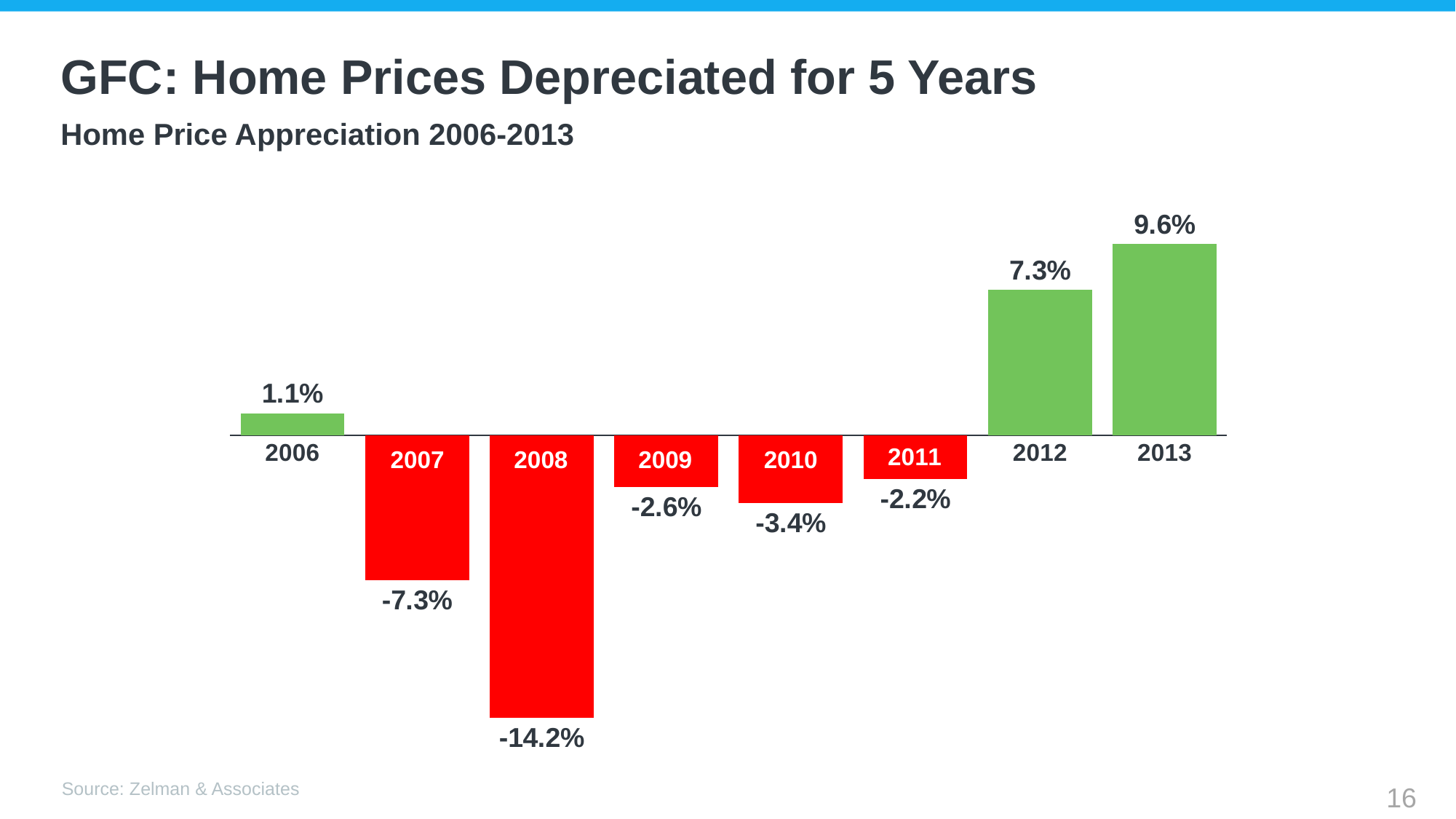
Which year has the highest home price appreciation? 2013 Which year has the larger value, 2009 or 2011? 2011 What kind of chart is shown on the slide? Bar chart How many years show a negative home price appreciation? 5 What is the home price appreciation value for 2013? 9.6% Which year has the lowest home price appreciation? 2008 What is the difference between the values for 2013 and 2012? 2.3% What is the home price appreciation value for 2008? -14.2% What is the title of the chart? Home Price Appreciation 2006-2013 What colour are the bars for years with negative values? Red How many years are shown in the chart? 8 What is the home price appreciation value for 2010? -3.4%